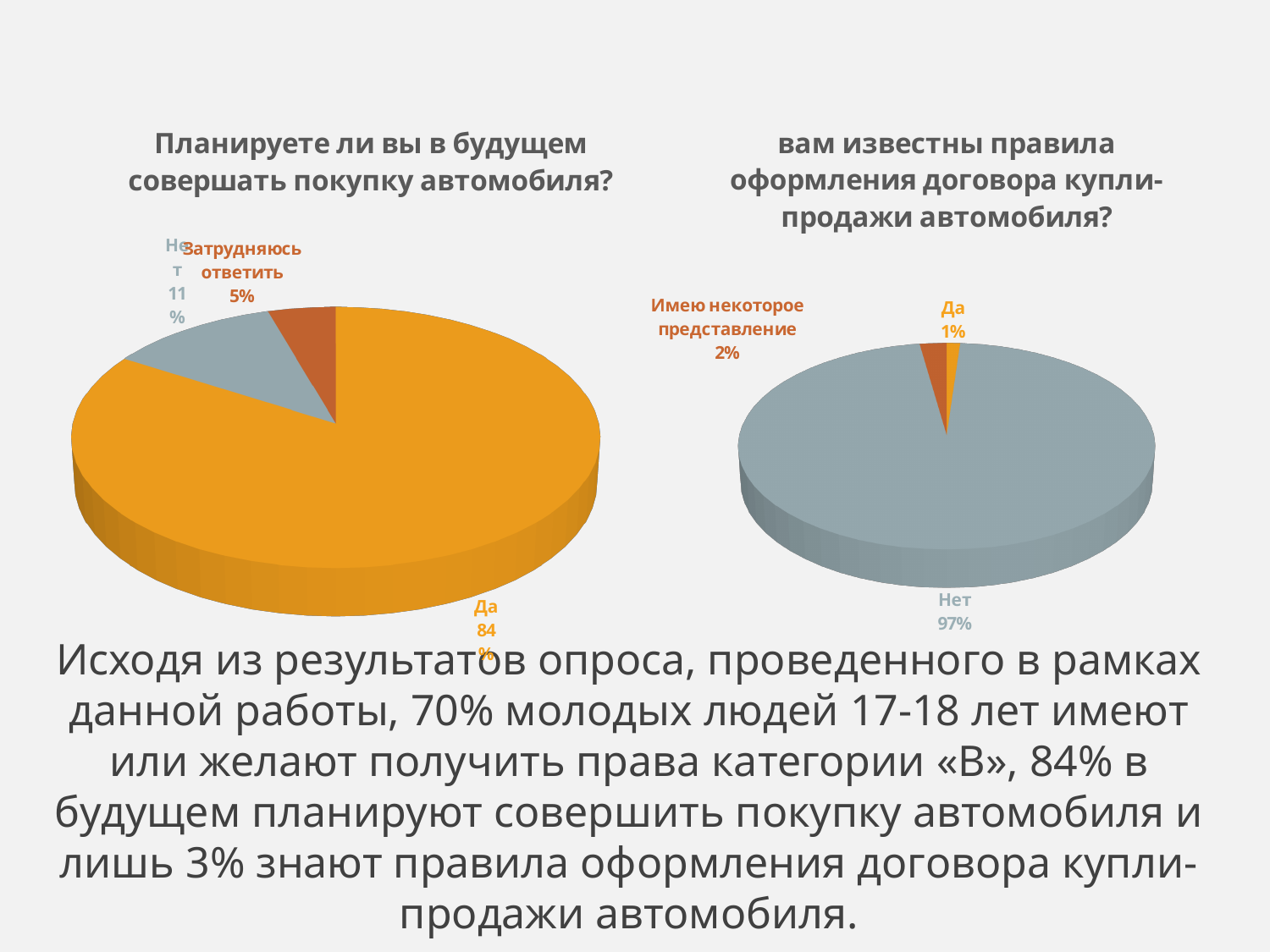
In the chart "вам известны правила оформления договора купли-продажи автомобиля?", which is larger, the share for "Имею некоторое представление" or the share for "Да"? Имею некоторое представление In the chart "Планируете ли вы в будущем совершать покупку автомобиля?", which slice is the smallest? Затрудняюсь ответить In the chart "Планируете ли вы в будущем совершать покупку автомобиля?", what share is labelled for "Затрудняюсь ответить"? 5% In the chart "Планируете ли вы в будущем совершать покупку автомобиля?", how many slices does the pie have? 3 In the chart "вам известны правила оформления договора купли-продажи автомобиля?", what share is labelled for "Да"? 1% What kind of chart is used for "Планируете ли вы в будущем совершать покупку автомобиля?"? Pie chart In the chart "вам известны правила оформления договора купли-продажи автомобиля?", what share is labelled for "Имею некоторое представление"? 2% In the chart "Планируете ли вы в будущем совершать покупку автомобиля?", what is the difference between the shares for "Да" and "Нет"? 73% In the chart "Планируете ли вы в будущем совершать покупку автомобиля?", which slice is the largest? Да In the chart "Планируете ли вы в будущем совершать покупку автомобиля?", what share is labelled for "Да"? 84% In the chart "вам известны правила оформления договора купли-продажи автомобиля?", what share is labelled for "Нет"? 97% In the chart "Планируете ли вы в будущем совершать покупку автомобиля?", what share is labelled for "Нет"? 11%